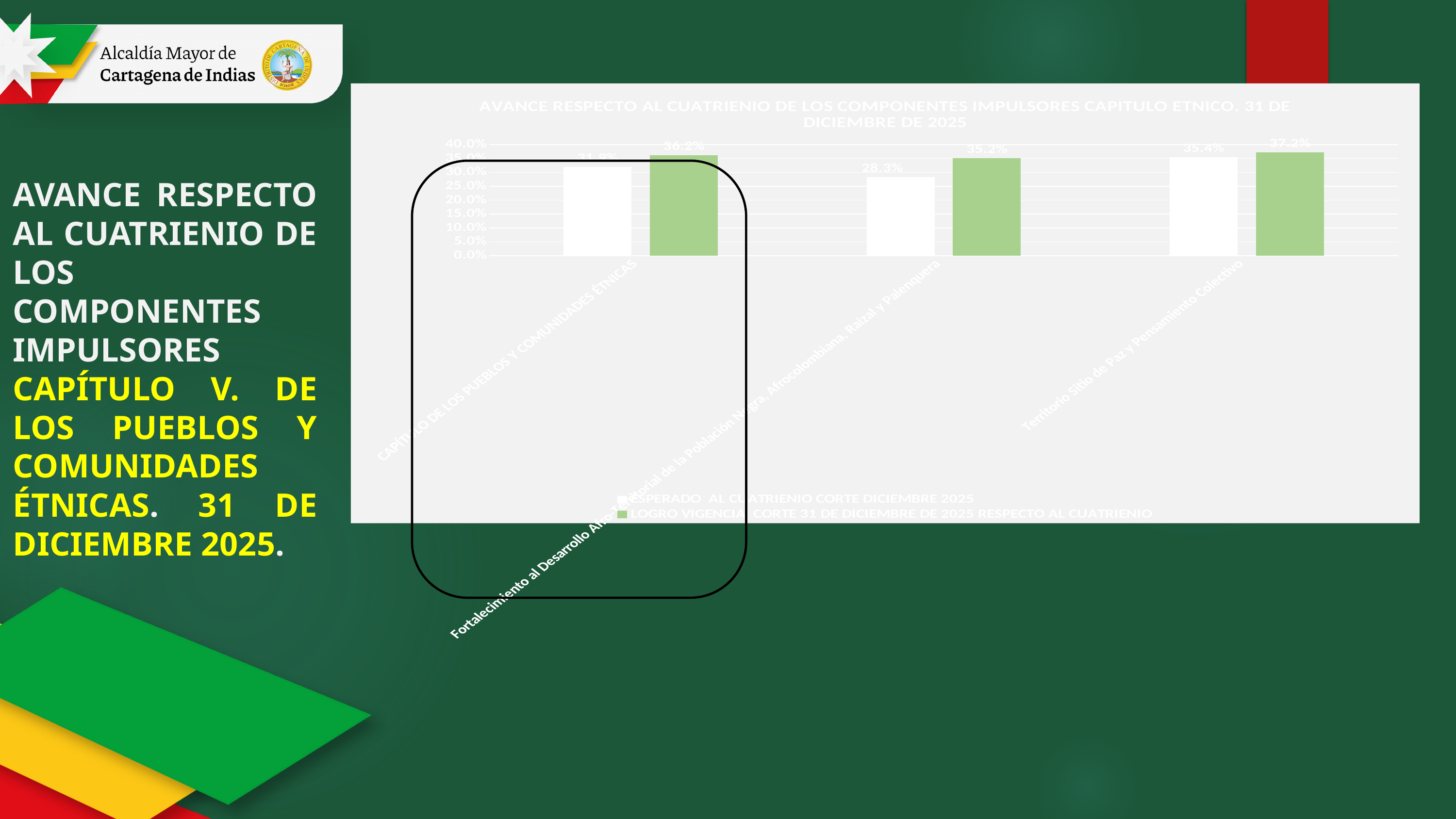
What is the difference between the LOGRO VIGENCIA value (35.2%) and the ESPERADO value (28.3%) for the middle category? 6.9% What is the ESPERADO AL CUATRIENIO value for the middle category (Población Negra, Afrocolombiana, Raizal y Palenquera)? 28.3% How many categories are shown on the x axis of the chart? 3 What kind of chart is shown on the slide? Bar chart How many series does the chart legend list? 2 Which colour represents the LOGRO VIGENCIA series in the chart? Green What is the LOGRO VIGENCIA value for the first category, CAPÍTULO DE LOS PUEBLOS Y COMUNIDADES ÉTNICAS? 36.2% What is the LOGRO VIGENCIA value for the category Territorio Sitio de Paz y Pensamiento Colectivo? 37.2% What is the ESPERADO AL CUATRIENIO value for the category Territorio Sitio de Paz y Pensamiento Colectivo? 35.4% For the first category, CAPÍTULO DE LOS PUEBLOS Y COMUNIDADES ÉTNICAS, which is larger: the ESPERADO AL CUATRIENIO value or the LOGRO VIGENCIA value? LOGRO VIGENCIA Which category has the lowest ESPERADO AL CUATRIENIO value? Población Negra, Afrocolombiana, Raizal y Palenquera (middle category) Which category has the highest LOGRO VIGENCIA value? Territorio Sitio de Paz y Pensamiento Colectivo